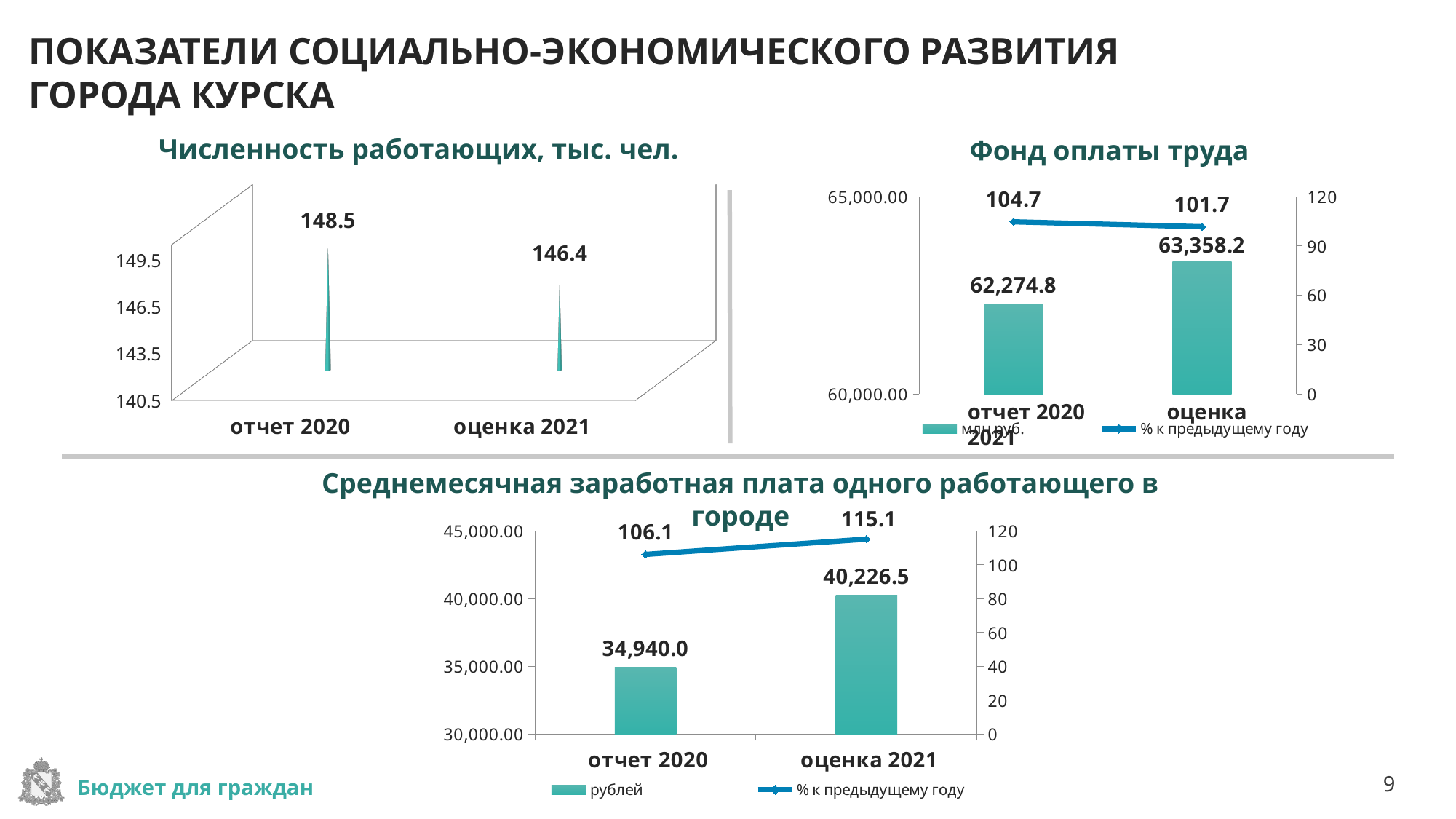
In the chart 'Среднемесячная заработная плата одного работающего в городе', what is the bar value for 'оценка 2021'? 40,226.5 In the chart 'Фонд оплаты труда', what is the bar value for 'отчет 2020'? 62,274.8 In the chart 'Численность работающих, тыс. чел.', what is the value for 'отчет 2020'? 148.5 In the chart 'Фонд оплаты труда', how many series does the legend list? 2 In the chart 'Среднемесячная заработная плата одного работающего в городе', what is the difference between the bar values for 'оценка 2021' and 'отчет 2020'? 5,286.5 In the chart 'Численность работающих, тыс. чел.', what is the value for 'оценка 2021'? 146.4 In the chart 'Численность работающих, тыс. чел.', what is the difference between the 'отчет 2020' and 'оценка 2021' values? 2.1 In the chart 'Фонд оплаты труда', which category has the higher bar value? оценка 2021 In the chart 'Среднемесячная заработная плата одного работающего в городе', what is the '% к предыдущему году' value for 'отчет 2020'? 106.1 In the chart 'Фонд оплаты труда', what is the '% к предыдущему году' value for 'оценка 2021'? 101.7 In the chart 'Среднемесячная заработная плата одного работающего в городе', what does the legend label the bar series? рублей In the chart 'Численность работающих, тыс. чел.', does the value rise or fall from 'отчет 2020' to 'оценка 2021'? fall